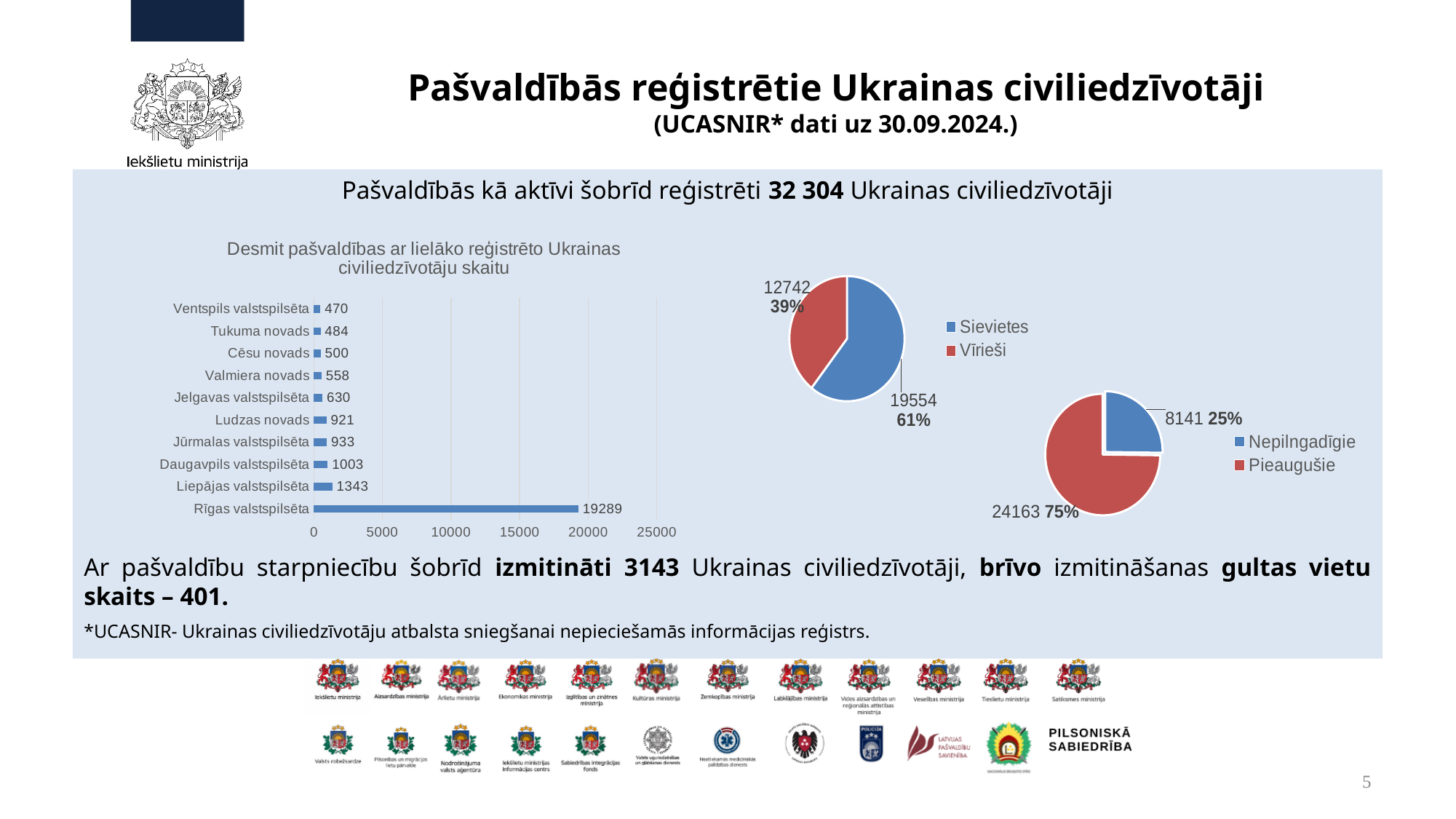
In the pie chart with the legend Nepilngadīgie and Pieaugušie, what share of the pie is Nepilngadīgie? 25% In the bar chart 'Desmit pašvaldības ar lielāko reģistrēto Ukrainas civiliedzīvotāju skaitu', what is the value for Rīgas valstspilsēta? 19289 What type of chart is 'Desmit pašvaldības ar lielāko reģistrēto Ukrainas civiliedzīvotāju skaitu'? Bar chart In the bar chart 'Desmit pašvaldības ar lielāko reģistrēto Ukrainas civiliedzīvotāju skaitu', which municipality has the highest value? Rīgas valstspilsēta In the bar chart 'Desmit pašvaldības ar lielāko reģistrēto Ukrainas civiliedzīvotāju skaitu', which is larger, Ludzas novads or Jelgavas valstspilsēta? Ludzas novads In the bar chart 'Desmit pašvaldības ar lielāko reģistrēto Ukrainas civiliedzīvotāju skaitu', what is the value for Liepājas valstspilsēta? 1343 In the bar chart 'Desmit pašvaldības ar lielāko reģistrēto Ukrainas civiliedzīvotāju skaitu', which municipality has the lowest value? Ventspils valstspilsēta In the bar chart 'Desmit pašvaldības ar lielāko reģistrēto Ukrainas civiliedzīvotāju skaitu', what is the difference between Daugavpils valstspilsēta and Jūrmalas valstspilsēta? 70 In the pie chart with the legend Sievietes and Vīrieši, what is the value for Sievietes? 19554 In the pie chart with the legend Nepilngadīgie and Pieaugušie, what is the value for Pieaugušie? 24163 In the pie chart with the legend Sievietes and Vīrieši, what share of the pie is Vīrieši? 39% How many municipalities are shown in the bar chart 'Desmit pašvaldības ar lielāko reģistrēto Ukrainas civiliedzīvotāju skaitu'? 10